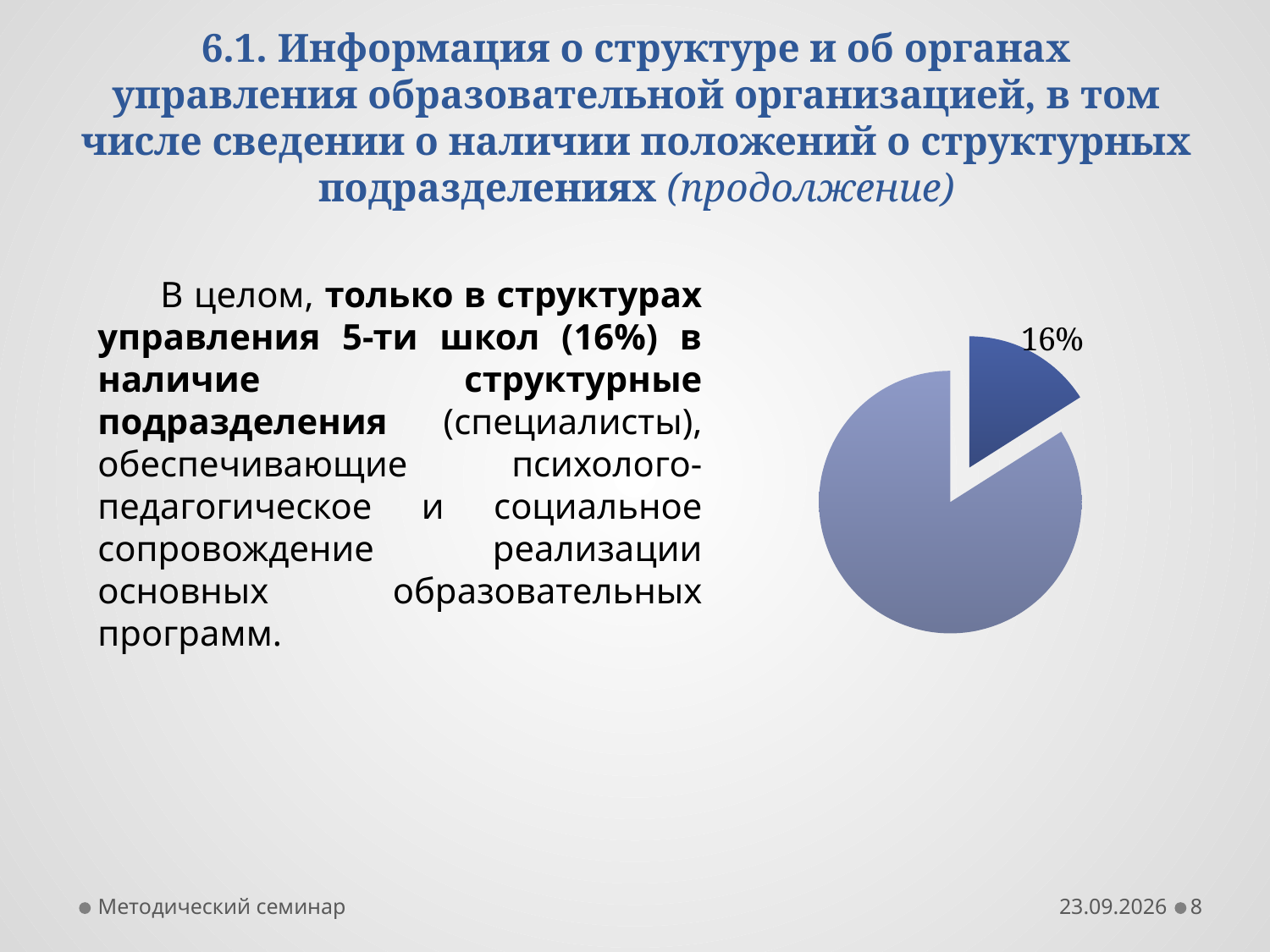
Is the share of the large unlabelled slice greater or less than 50%? greater Which slice of the pie chart is larger, the separated dark blue slice or the remaining lighter blue slice? the remaining lighter blue slice What value is printed on the small, separated slice of the pie chart? 16% What kind of chart is shown on the slide? pie chart How many slices of the pie chart carry a data label? 1 Does the pie chart have a legend? no How many slices does the pie chart have? 2 What share of the pie does the labelled slice represent? 16%